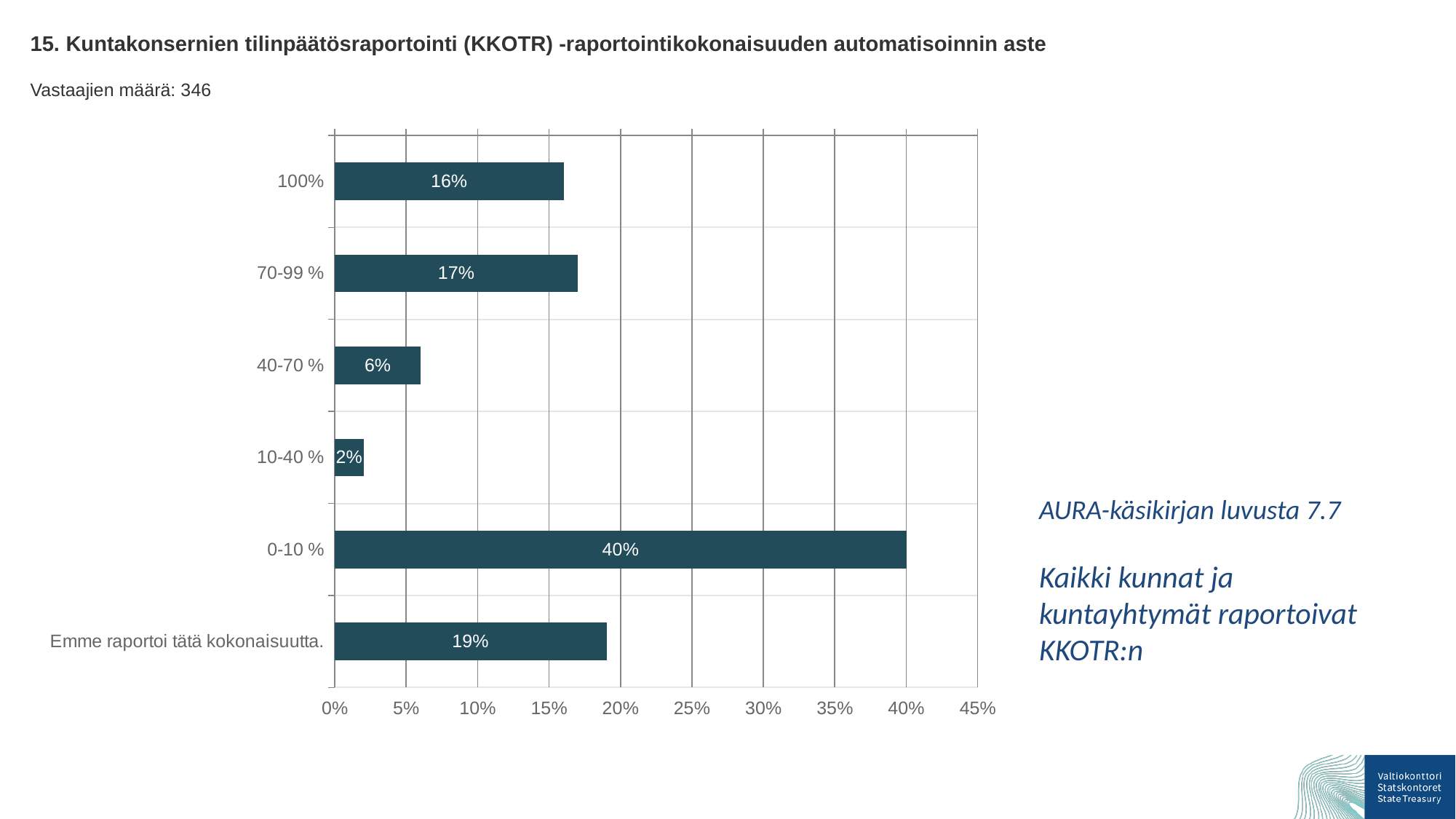
Which is larger, the value for 70-99 % or the value for 40-70 %? 70-99 % How many categories are shown in the chart? 6 Which category has the highest value? 0-10 % What is the value for the 0-10 % category? 40% Is the value for 'Emme raportoi tätä kokonaisuutta.' greater or less than 15%? greater What is the highest tick value shown on the x axis? 45% Which category has the lowest value? 10-40 % What kind of chart is shown on the slide? bar chart What is the value for the 70-99 % category? 17% What is the value for the 'Emme raportoi tätä kokonaisuutta.' category? 19% What is the difference between the values for 0-10 % and 100%? 24% What is the number of respondents (Vastaajien määrä) stated on the slide? 346